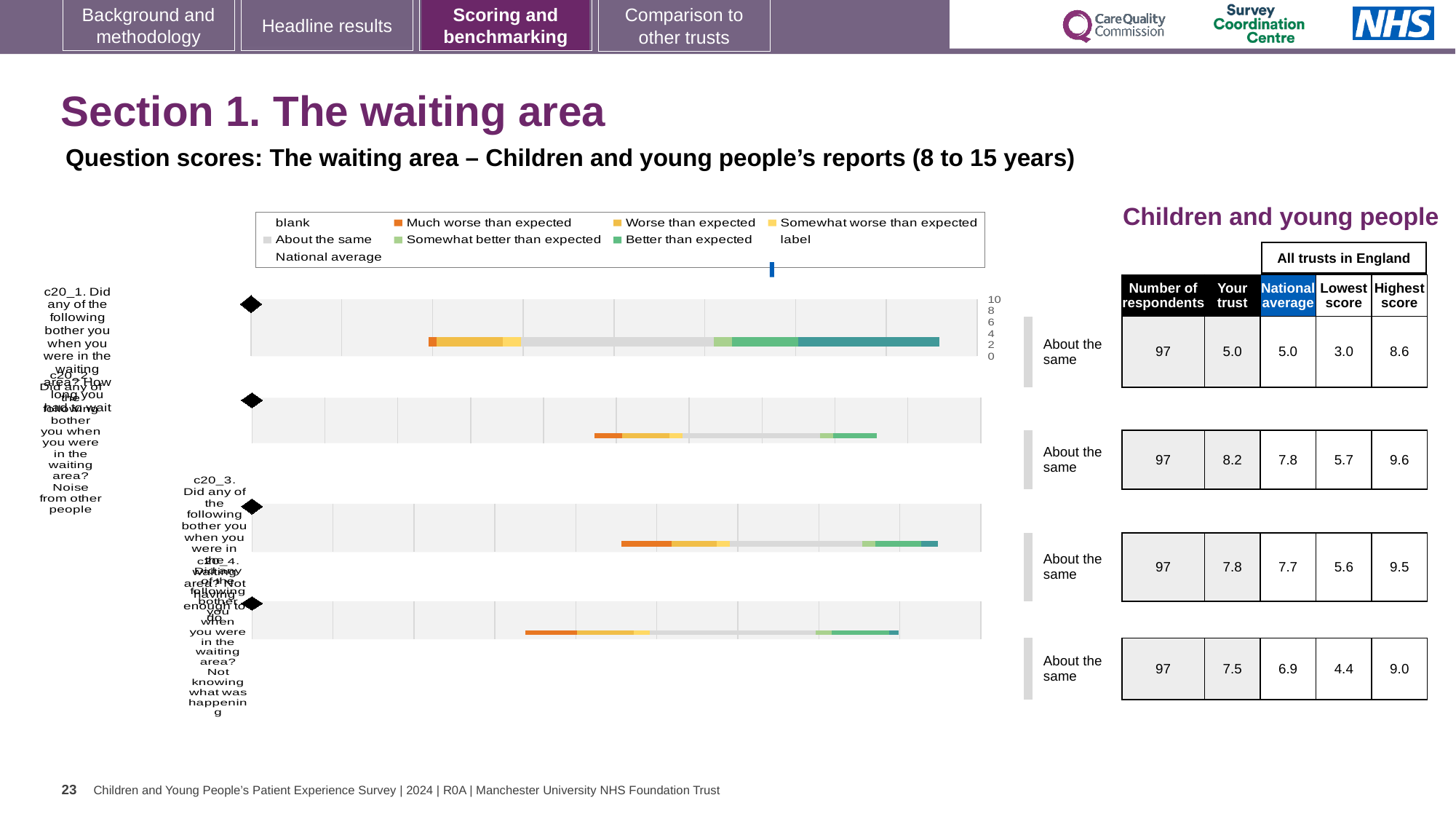
How many respondents are shown for each question row? 97 How many question rows (bars) are plotted in the chart? 4 Which question row has the highest 'Your trust' score? c20_2 (second row), 8.2 What is the lowest score across all trusts in England for the fourth question row (c20_4, not knowing what was happening)? 4.4 What is the 'Your trust' score for the first question row (c20_1, how long you had to wait)? 5.0 For the fourth question row (c20_4), which is larger: the 'Your trust' score or the national average? Your trust What is the national average for the second question row (c20_2)? 7.8 For the second question row (c20_2), what is the difference between the 'Your trust' score and the national average? 0.4 What is the highest score across all trusts in England for the third question row (c20_3)? 9.5 What kind of chart is shown on the slide? bar chart What benchmark rating is shown next to each of the four bars? About the same Which question row has the lowest 'Your trust' score? c20_1 (first row), 5.0